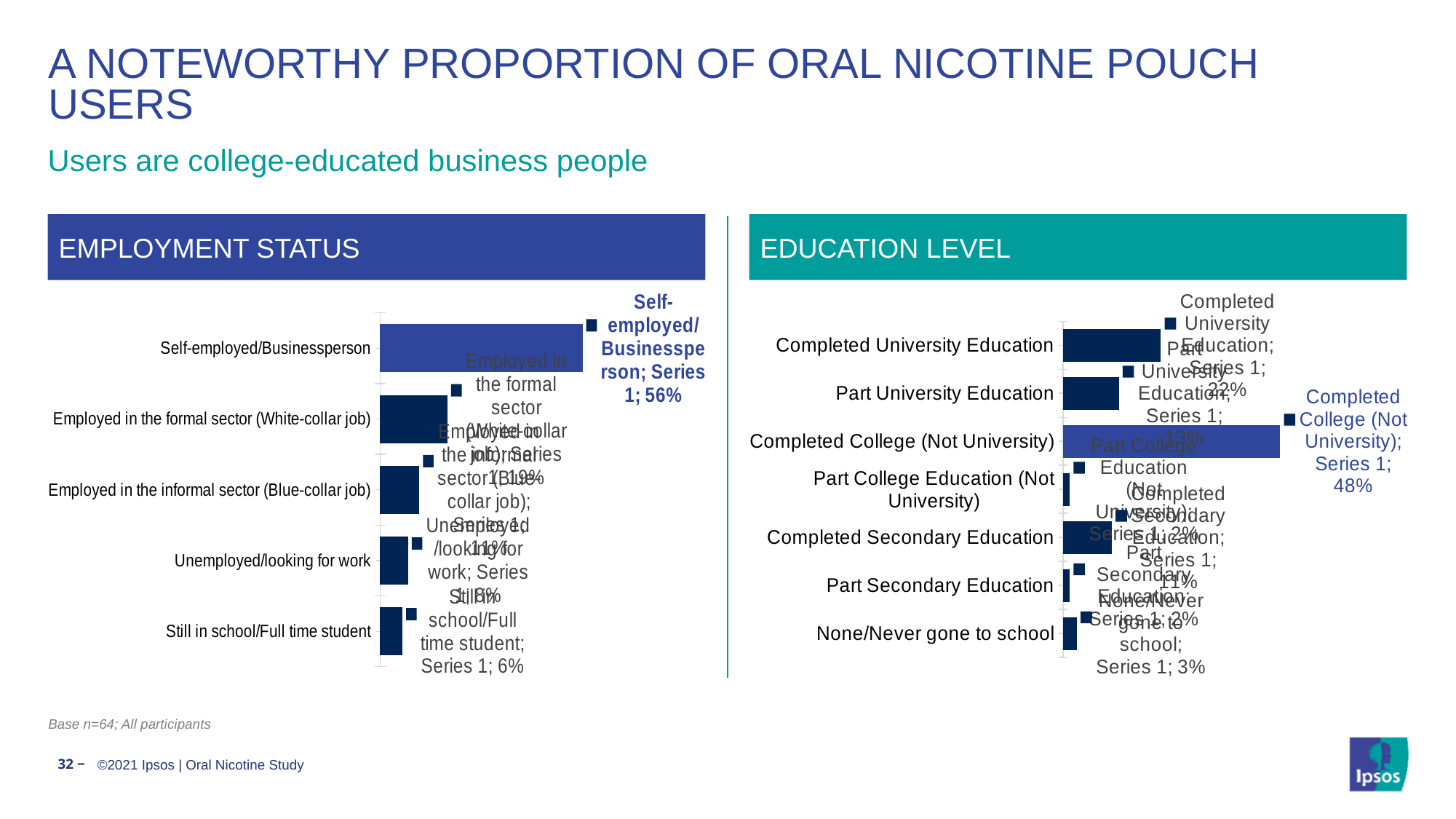
In the Education Level chart, what is the value for None/Never gone to school? 3% In the Education Level chart, what is the value for Completed University Education? 22% In the Employment Status chart, what is the value for Self-employed/Businessperson? 56% What type of chart is the Education Level chart? Bar chart In the Employment Status chart, which is larger: Employed in the formal sector (White-collar job) or Employed in the informal sector (Blue-collar job)? Employed in the formal sector (White-collar job) In the Employment Status chart, how many categories are shown? 5 In the Education Level chart, what is the difference between Completed College (Not University) and Completed University Education? 26% In the Employment Status chart, which category has the highest value? Self-employed/Businessperson In the Employment Status chart, which category has the lowest value? Still in school/Full time student In the Education Level chart, what is the value for Completed College (Not University)? 48% In the Employment Status chart, what is the value for Still in school/Full time student? 6% In the Education Level chart, which category has the highest value? Completed College (Not University)